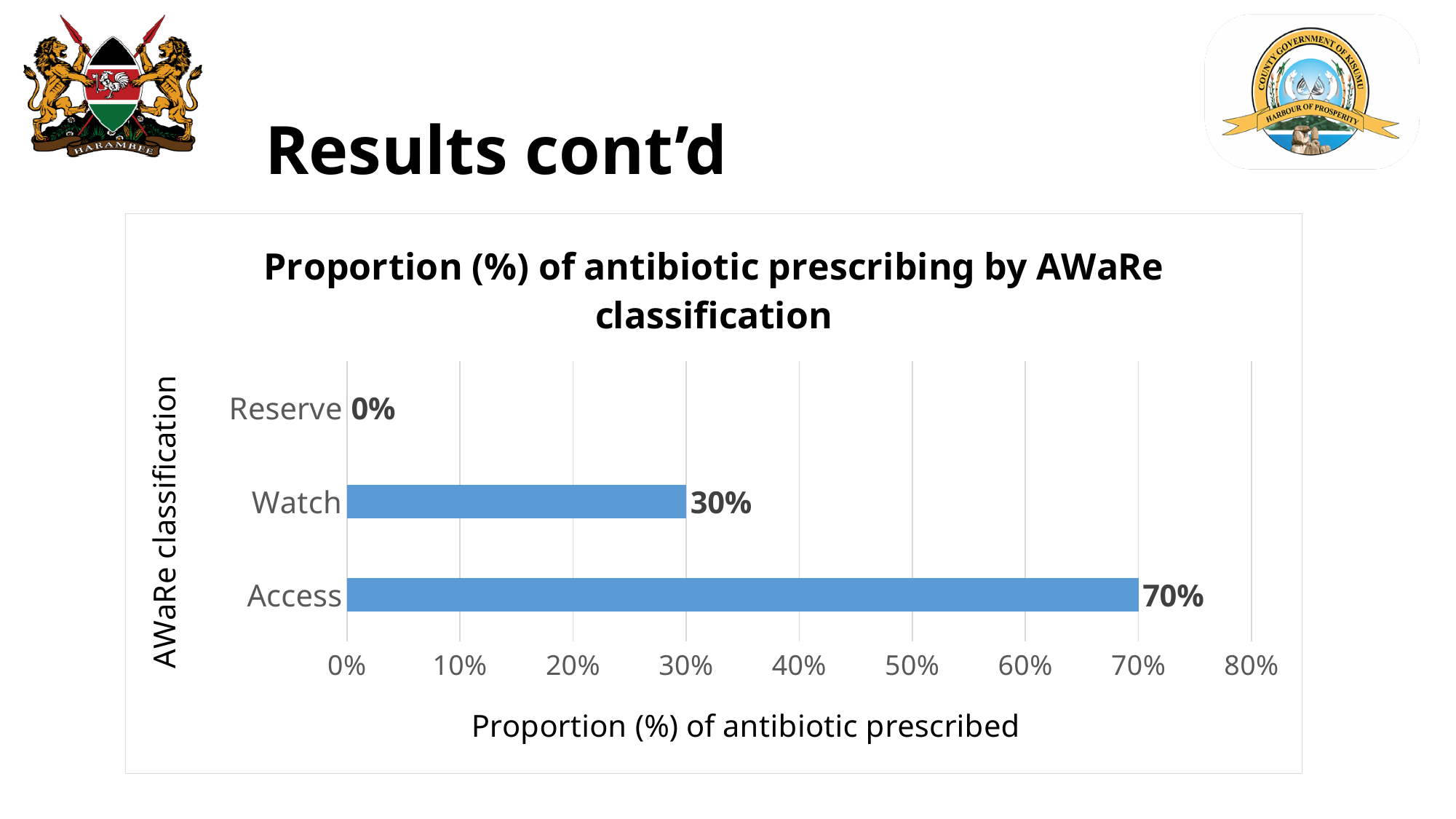
Which has a larger proportion of antibiotic prescribing, Watch or Access? Access What is the proportion of antibiotic prescribing for the Reserve classification? 0% What is the proportion of antibiotic prescribing for the Access classification? 70% What is the proportion of antibiotic prescribing for the Watch classification? 30% Which AWaRe classification has the highest proportion of antibiotic prescribing? Access What is the title of the chart? Proportion (%) of antibiotic prescribing by AWaRe classification Is the value for Access greater or less than 50%? greater How many AWaRe classification categories are shown in the chart? 3 What is the difference between the proportions for Access and Watch? 40% Which AWaRe classification has the lowest proportion of antibiotic prescribing? Reserve What is the label of the horizontal axis of the chart? Proportion (%) of antibiotic prescribed What kind of chart is shown on the slide? Bar chart